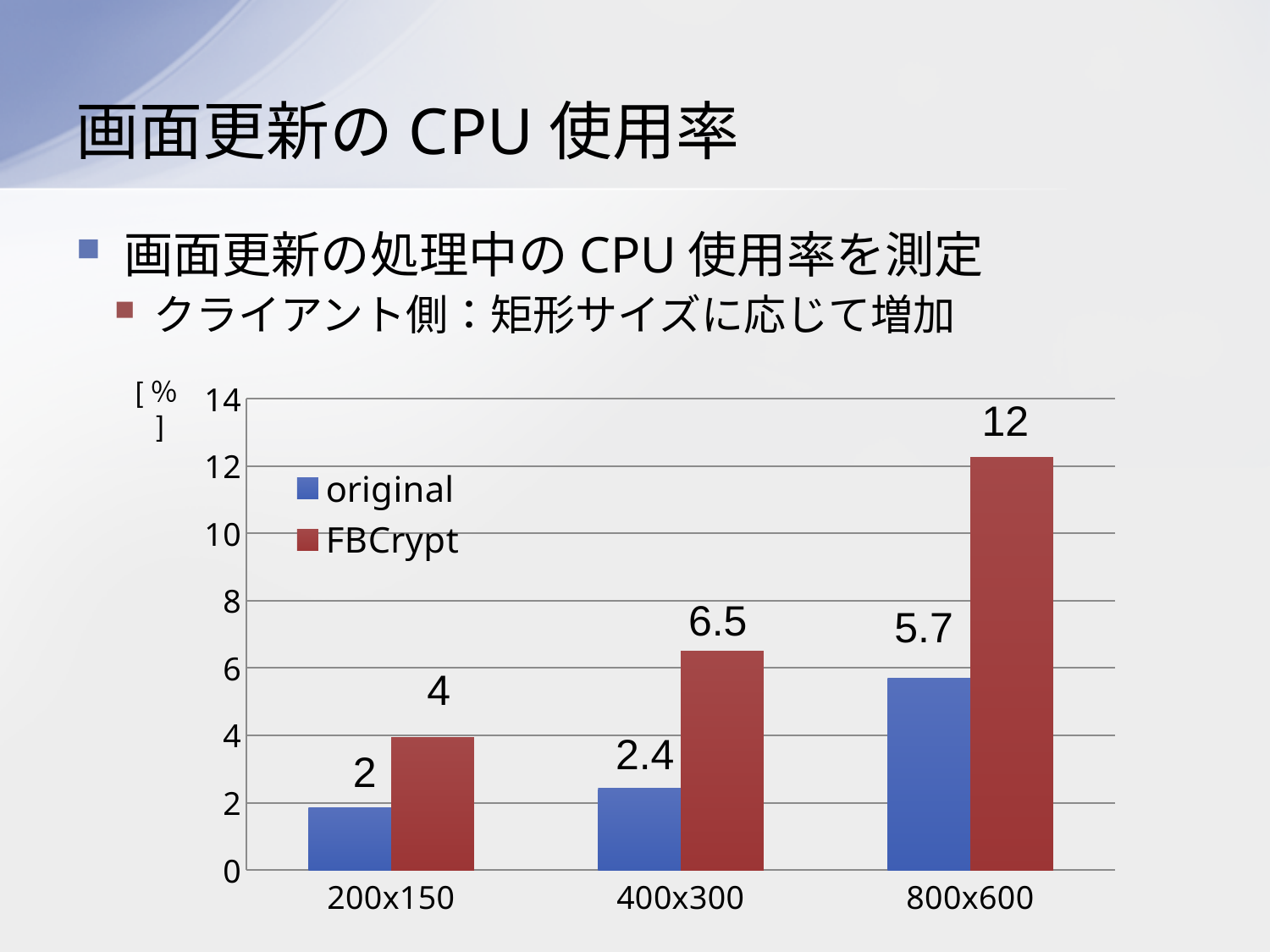
What kind of chart is shown on the slide? bar chart Which category has the highest value for FBCrypt? 800x600 What is the difference between FBCrypt and original at 800x600? 6.3 How many series does the legend list? 2 What is the value for original at 400x300? 2.4 Which category has the lowest value for original? 200x150 What is the value for FBCrypt at 800x600? 12 What is the value for FBCrypt at 200x150? 4 Do the FBCrypt values rise or fall from 200x150 to 800x600? rise What is the value for original at 800x600? 5.7 How many categories are shown on the x axis? 3 Which is larger at 400x300, original or FBCrypt? FBCrypt